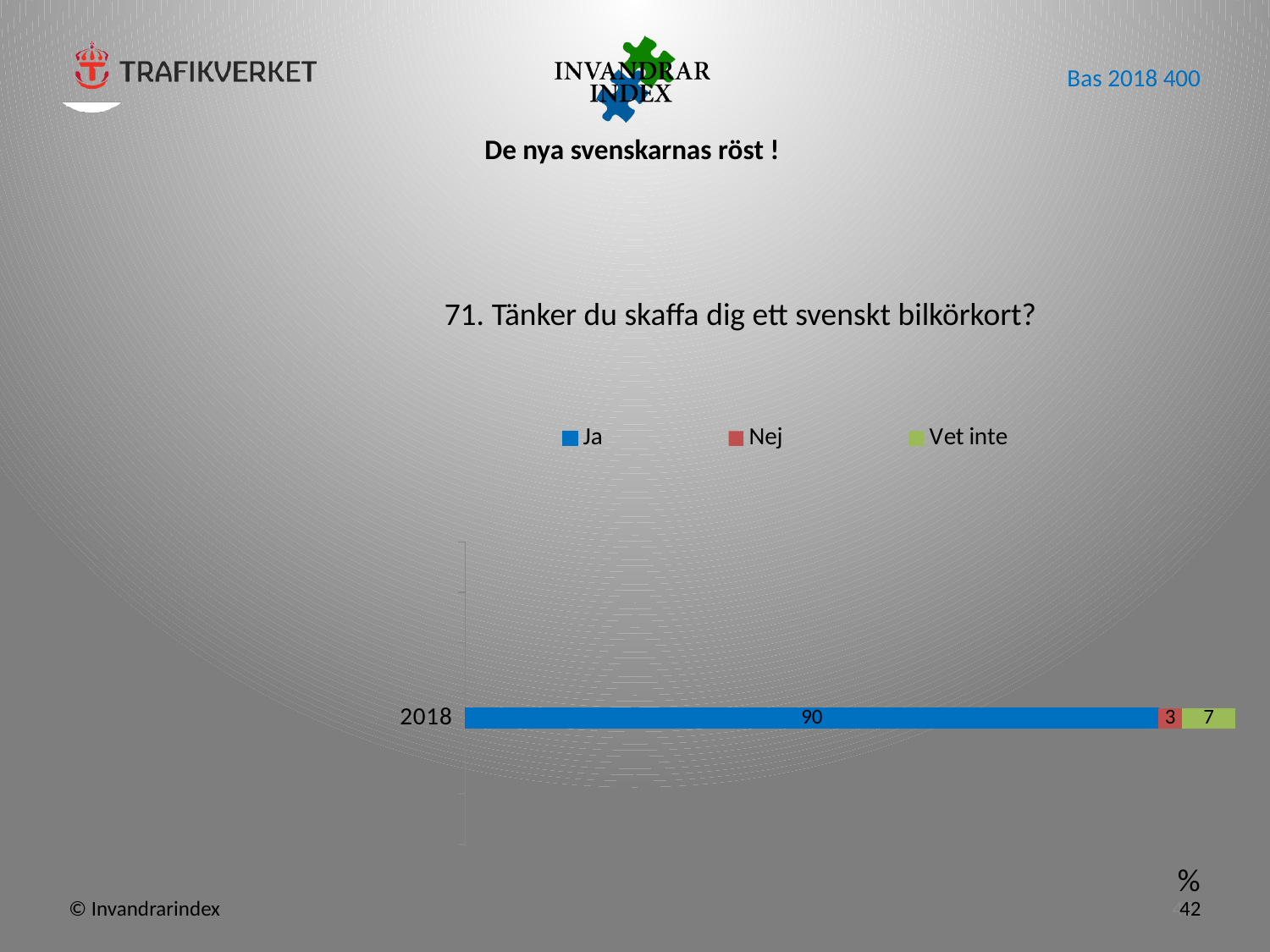
How many categories are shown on the chart? 1 Which series has the lowest value in 2018? Nej Which is larger in 2018, Vet inte or Nej? Vet inte What is the value for Vet inte in 2018? 7 What is the value for Nej in 2018? 3 What is the difference between the Ja and Vet inte values in 2018? 83 What is the title of the chart? 71. Tänker du skaffa dig ett svenskt bilkörkort? How many series does the legend list? 3 Which series has the highest value in 2018? Ja What kind of chart is shown? Stacked bar chart What is the total of the stacked bar for 2018? 100 What is the value for Ja in 2018? 90